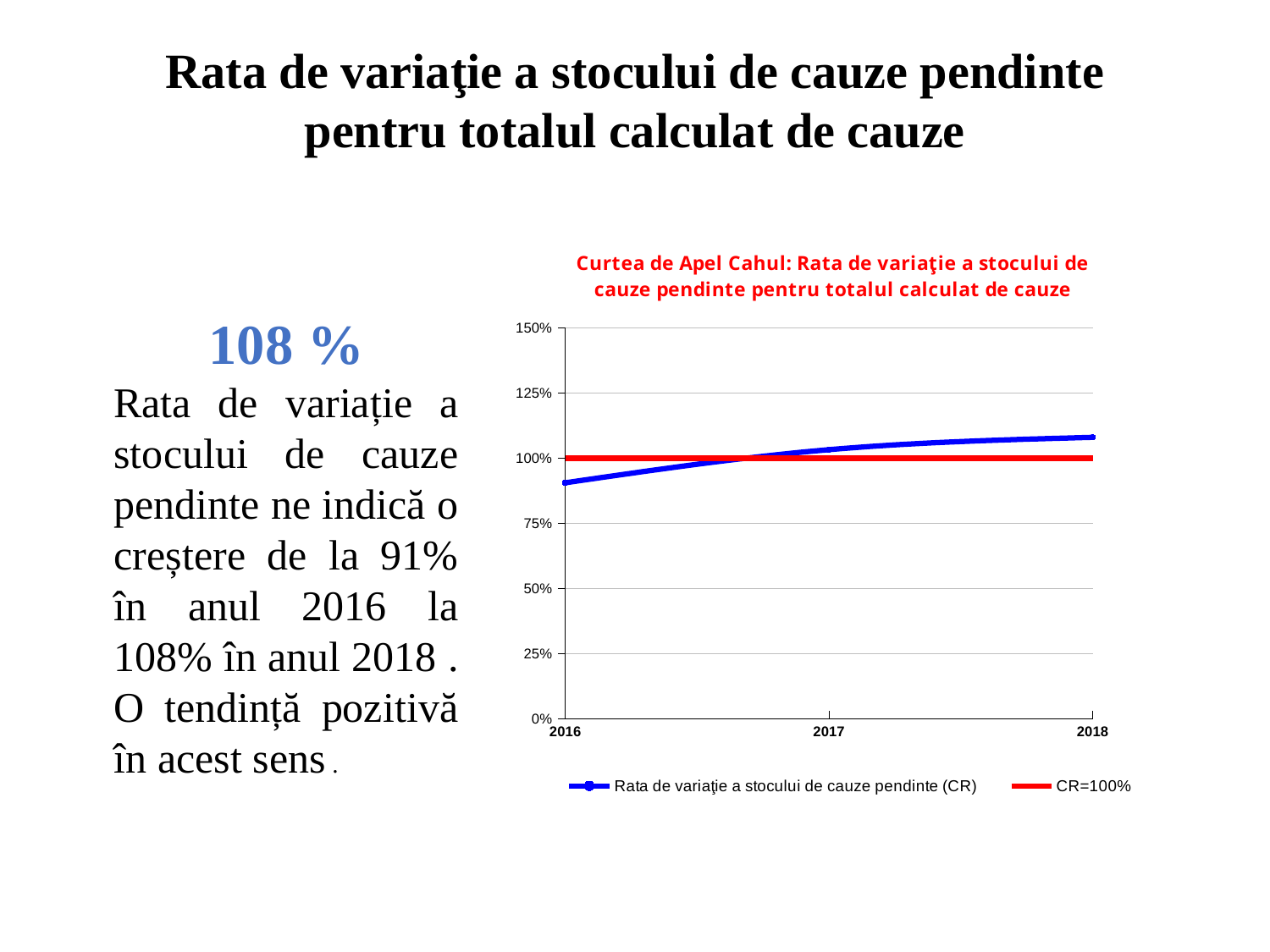
Does the 'Rata de variaţie a stocului de cauze pendinte (CR)' line rise or fall from 2016 to 2018? rise Is the value of 'Rata de variaţie a stocului de cauze pendinte (CR)' in 2017 greater or less than 125%? less What colour is the 'CR=100%' line on the chart? red What kind of chart is shown on the slide? line chart At what value does the 'CR=100%' reference line sit on the chart? 100% Is the value of 'Rata de variaţie a stocului de cauze pendinte (CR)' in 2016 greater or less than 100%? less Which year has the higher value for 'Rata de variaţie a stocului de cauze pendinte (CR)', 2016 or 2018? 2018 In which year is 'Rata de variaţie a stocului de cauze pendinte (CR)' highest? 2018 How many series does the chart legend list? 2 Is the value of 'Rata de variaţie a stocului de cauze pendinte (CR)' in 2018 greater or less than 100%? greater How many years are shown on the x axis of the chart? 3 In which year is 'Rata de variaţie a stocului de cauze pendinte (CR)' lowest? 2016